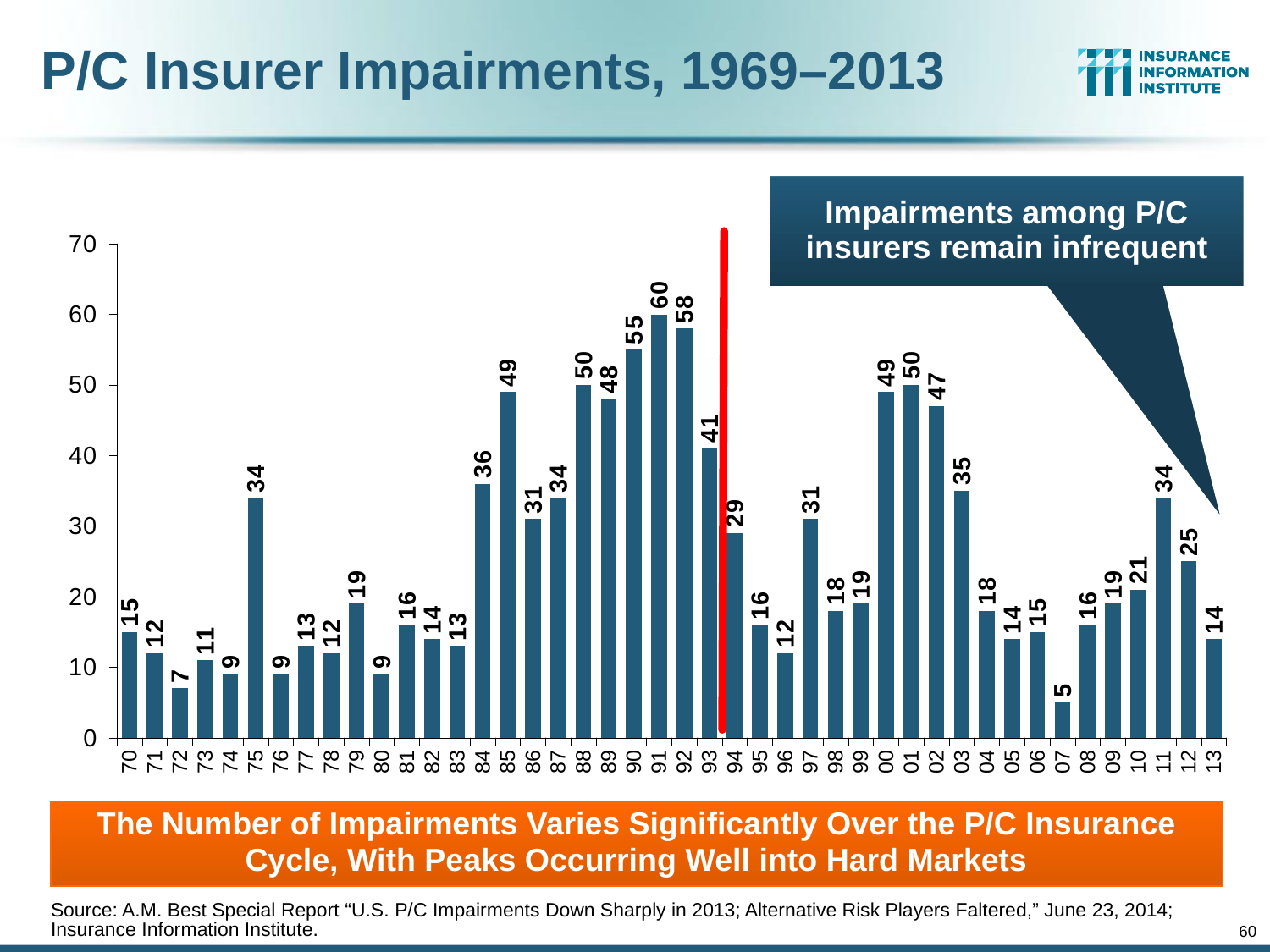
What value is shown for 2013 (labelled '13')? 14 What is the number of P/C insurer impairments shown for 1991 (labelled '91')? 60 What is the value for 2007 (labelled '07')? 5 Which year has the highest number of impairments? 91 Is the value for 2011 ('11') greater or less than 30? greater What is the difference between the values for 1992 ('92') and 1993 ('93')? 17 Do the values rise or fall from 1984 ('84') to 1991 ('91')? Rise What kind of chart is shown on the slide? Bar chart What is the title of the chart on the slide? P/C Insurer Impairments, 1969–2013 Which year has a larger value, 2001 ('01') or 2002 ('02')? 01 How many bars are plotted in the chart? 44 Which year has the lowest number of impairments? 07